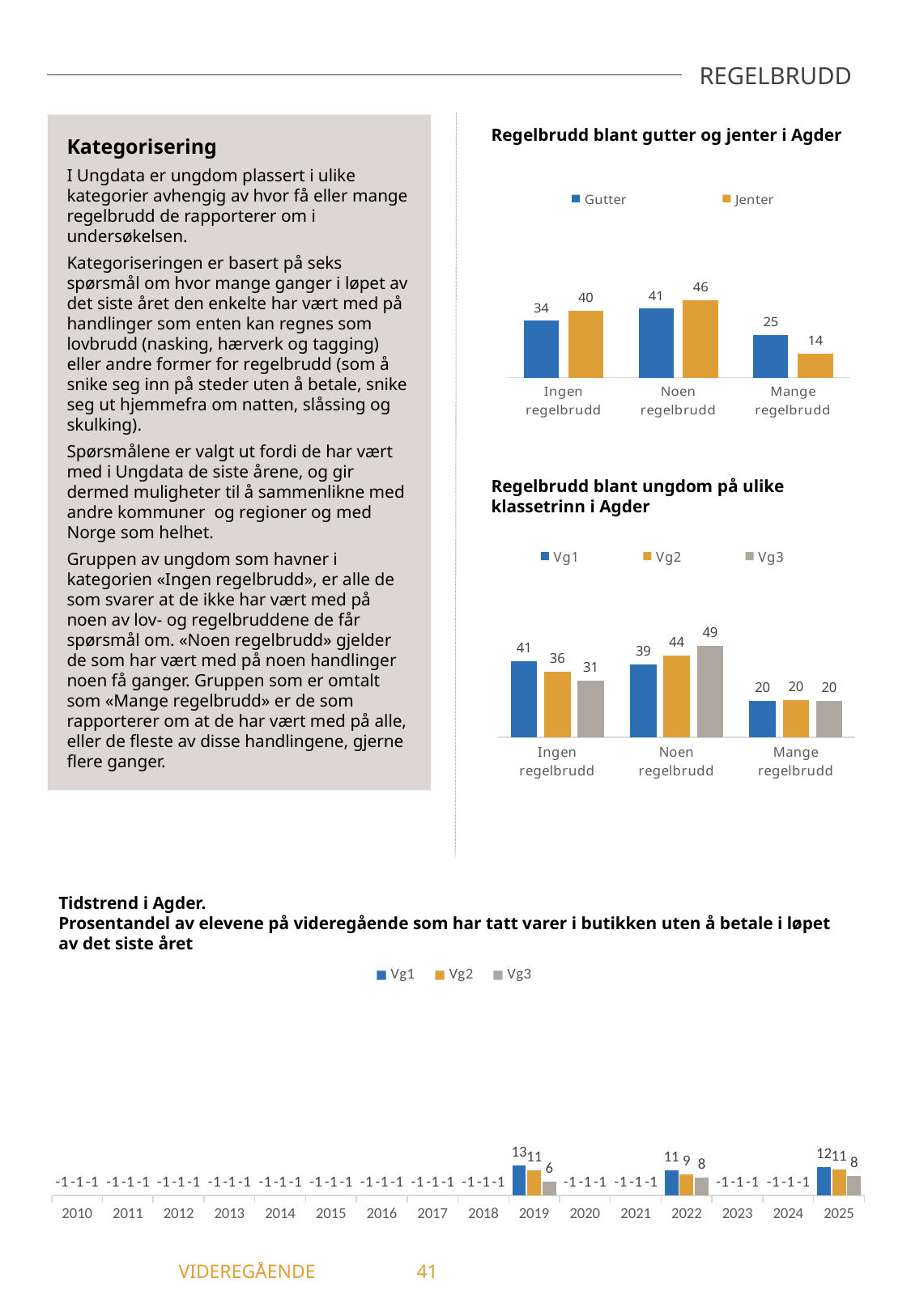
In the chart 'Regelbrudd blant ungdom på ulike klassetrinn i Agder', what is the difference between Vg1 and Vg3 in the 'Ingen regelbrudd' category? 10 In the chart 'Regelbrudd blant gutter og jenter i Agder', what is the difference between Gutter and Jenter in the 'Mange regelbrudd' category? 11 In the chart 'Regelbrudd blant ungdom på ulike klassetrinn i Agder', what is the value for Vg3 in the 'Noen regelbrudd' category? 49 What kind of chart is 'Tidstrend i Agder'? Bar chart In the chart 'Regelbrudd blant gutter og jenter i Agder', how many series does the legend list? 2 In the chart 'Regelbrudd blant gutter og jenter i Agder', what is the value for Gutter in the 'Mange regelbrudd' category? 25 In the chart 'Regelbrudd blant ungdom på ulike klassetrinn i Agder', which series has the highest value in the 'Ingen regelbrudd' category? Vg1 In the chart 'Regelbrudd blant gutter og jenter i Agder', which series has the higher value for 'Ingen regelbrudd', Gutter or Jenter? Jenter In the chart 'Tidstrend i Agder', what is the value for Vg1 in 2019? 13 In the chart 'Regelbrudd blant ungdom på ulike klassetrinn i Agder', how many categories are shown on the x axis? 3 In the chart 'Tidstrend i Agder', what is the value for Vg3 in 2025? 8 In the chart 'Regelbrudd blant gutter og jenter i Agder', what is the value for Jenter in the 'Noen regelbrudd' category? 46